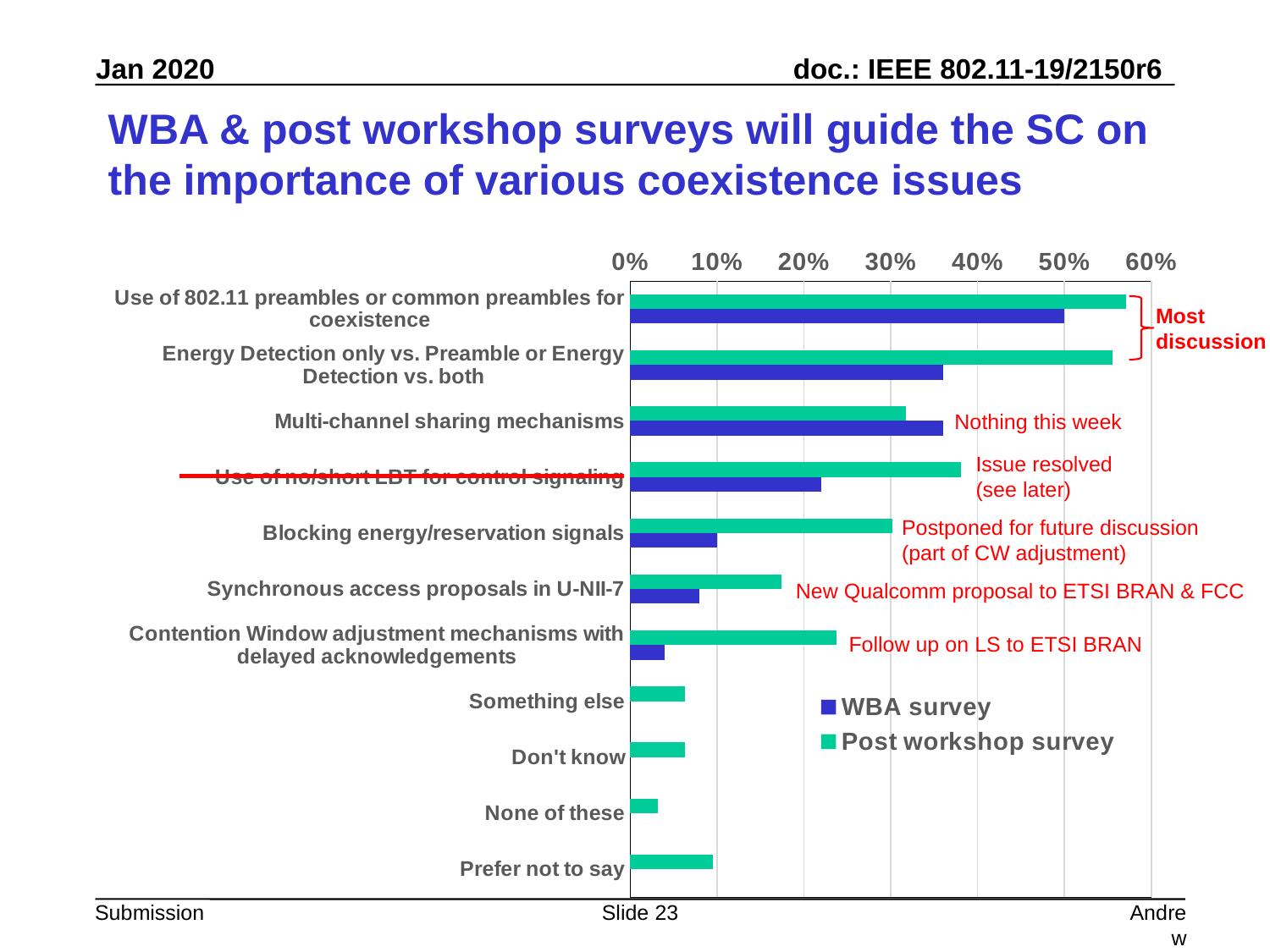
Is the Post workshop survey value for Energy Detection only vs. Preamble or Energy Detection vs. both greater or less than 50%? greater Which colour represents the WBA survey series in the chart? blue How many categories are plotted on the chart? 11 Is the Post workshop survey value for Contention Window adjustment mechanisms with delayed acknowledgements greater or less than 20%? greater How many series does the chart's legend list? 2 For Multi-channel sharing mechanisms, which series has the larger value, WBA survey or Post workshop survey? WBA survey Which category is marked with a strikethrough on the chart's axis labels? Use of no/short LBT for control signaling What kind of chart is shown on the slide? bar chart Which category has the lowest Post workshop survey value? None of these Is the WBA survey value for Blocking energy/reservation signals greater or less than 20%? less For Use of no/short LBT for control signaling, which series has the larger value, WBA survey or Post workshop survey? Post workshop survey Which category has the highest Post workshop survey value? Use of 802.11 preambles or common preambles for coexistence